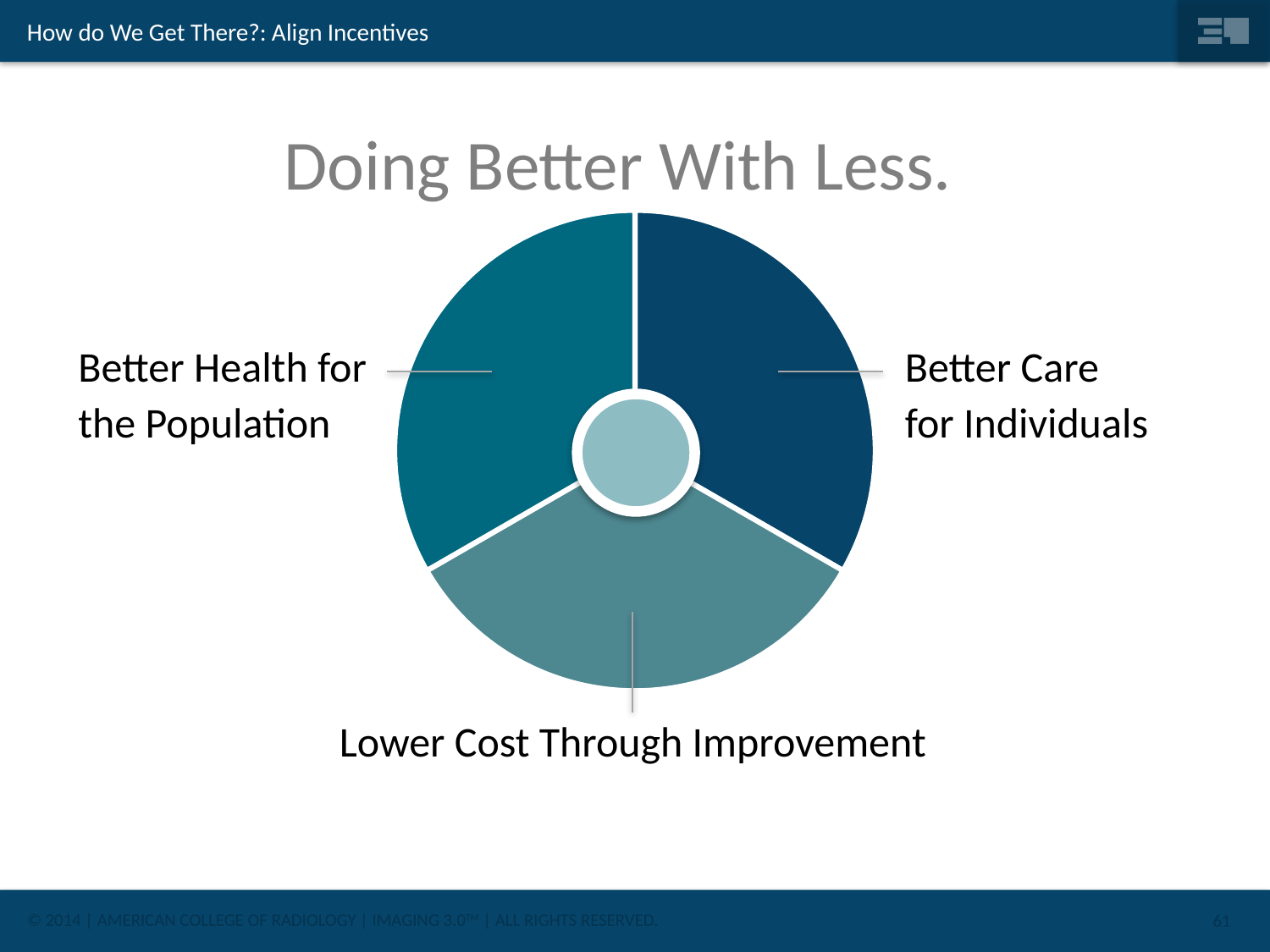
What kind of chart is shown on the slide? pie chart What is the label of the slice on the right side of the pie chart? Better Care for Individuals What is the label of the slice on the left side of the pie chart? Better Health for the Population Which slice label appears below the pie chart? Lower Cost Through Improvement What is the title shown above the pie chart? Doing Better With Less. How many slices does the pie chart have? 3